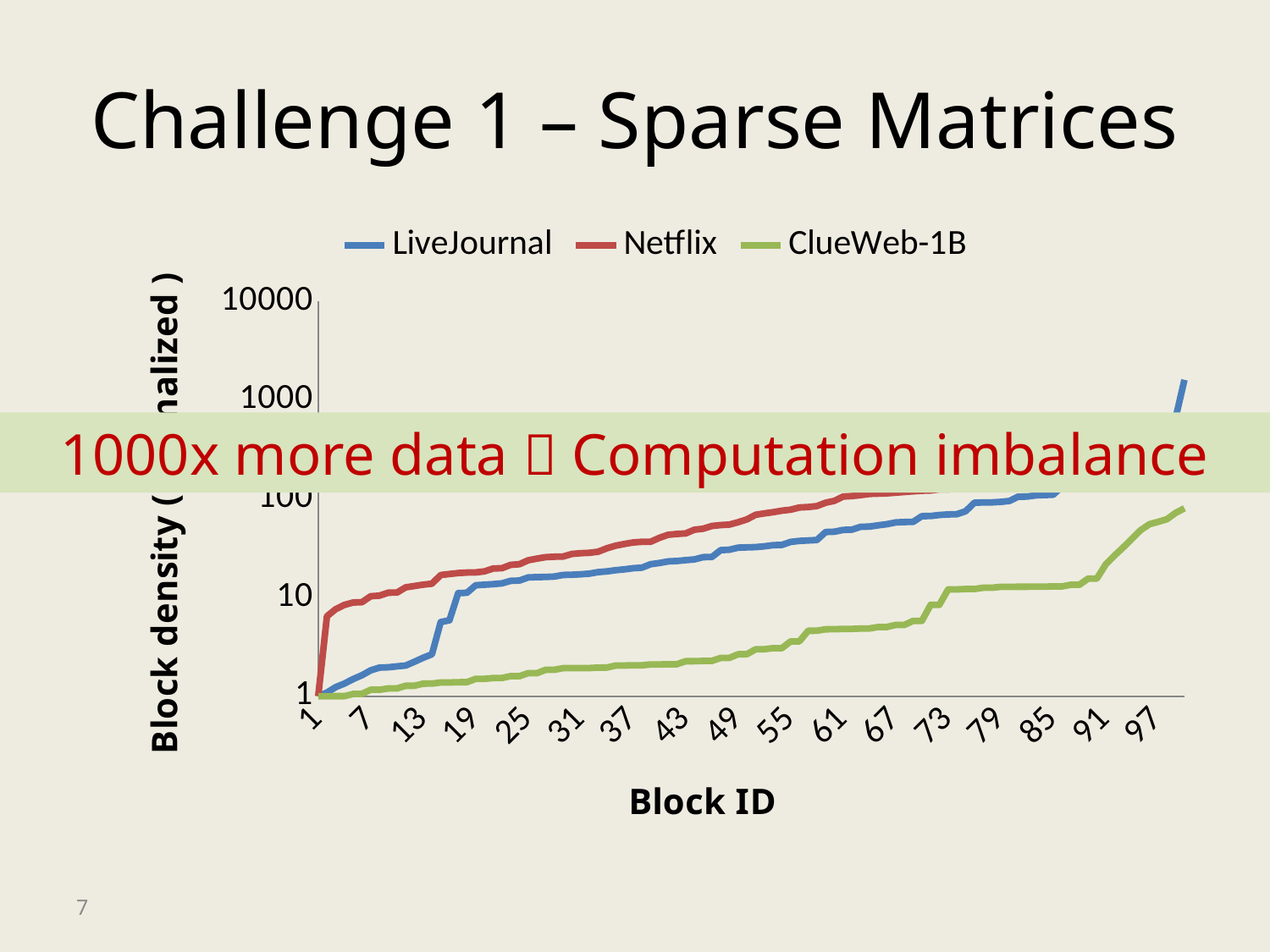
At Block ID 49, which series has the lowest value? ClueWeb-1B Is the value for ClueWeb-1B at Block ID 97 greater or less than 100? less Is the value for ClueWeb-1B at Block ID 49 greater or less than 10? less Do the values for the Netflix series rise or fall as Block ID increases? rise Which series are listed in the legend? LiveJournal, Netflix, ClueWeb-1B What kind of chart is shown on the slide? line chart Is the value for LiveJournal at Block ID 13 greater or less than 10? less What is the title of the x axis? Block ID Do the values for the ClueWeb-1B series rise or fall as Block ID increases? rise At Block ID 49, which series has the higher value, Netflix or ClueWeb-1B? Netflix How many series does the legend list? 3